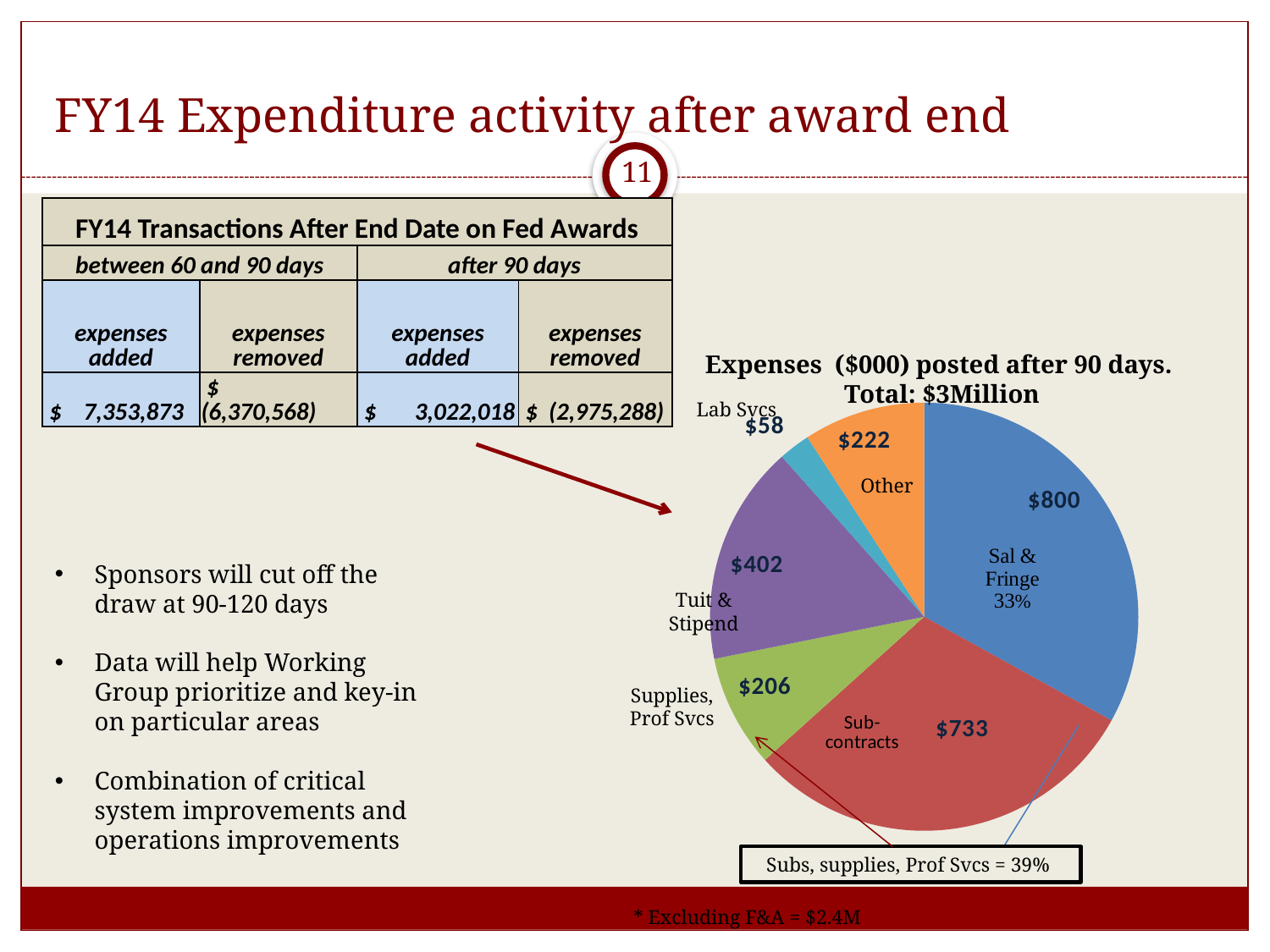
Which category has the smallest slice in the pie chart? Lab Svcs What is the value for Sal & Fringe in the pie chart? $800 Which is larger in the pie chart, Tuit & Stipend or Supplies, Prof Svcs? Tuit & Stipend How many slices does the pie chart have? 6 What share of the pie does Sal & Fringe represent, as labelled on the chart? 33% What is the value for Other in the pie chart? $222 What is the difference between the Sal & Fringe value and the Sub-contracts value? $67 Which category has the largest slice in the pie chart? Sal & Fringe What type of chart is shown on the slide? pie chart What is the value for Tuit & Stipend in the pie chart? $402 What is the value for Lab Svcs in the pie chart? $58 What is the value for Sub-contracts in the pie chart? $733